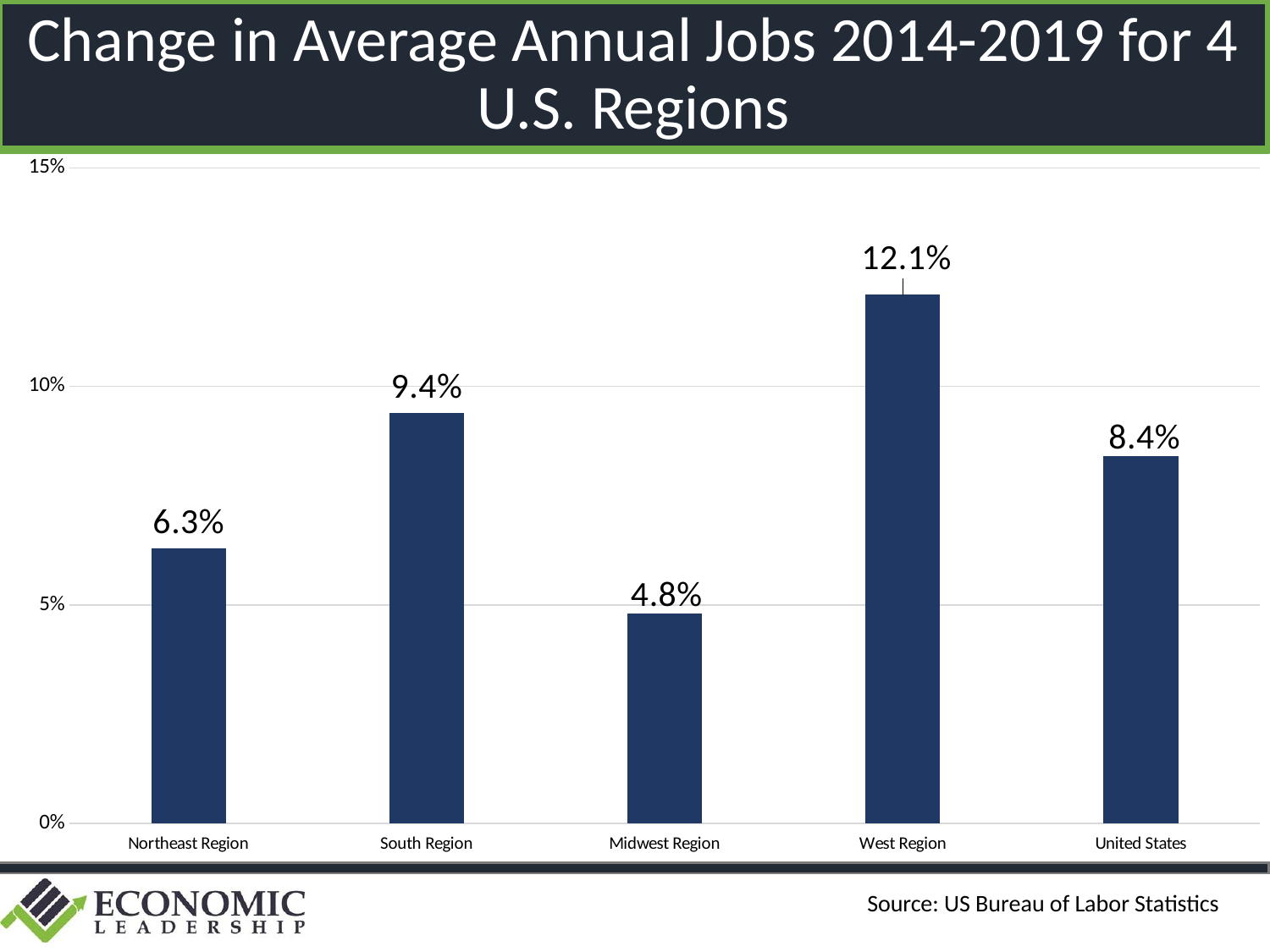
Which category has the lowest value? Midwest Region What is the change in average annual jobs for the Northeast Region? 6.3% What is the value shown for the West Region? 12.1% What is the difference between the West Region and the Midwest Region values? 7.3% Is the value for the West Region greater or less than 10%? greater What kind of chart is shown on the slide? bar chart How many categories are shown on the x axis? 5 What is the value shown for the United States? 8.4% What is the title of the chart? Change in Average Annual Jobs 2014-2019 for 4 U.S. Regions Which category has the highest value? West Region Which is larger, the value for the South Region or the value for the Northeast Region? South Region What is the difference between the South Region and the United States values? 1.0%